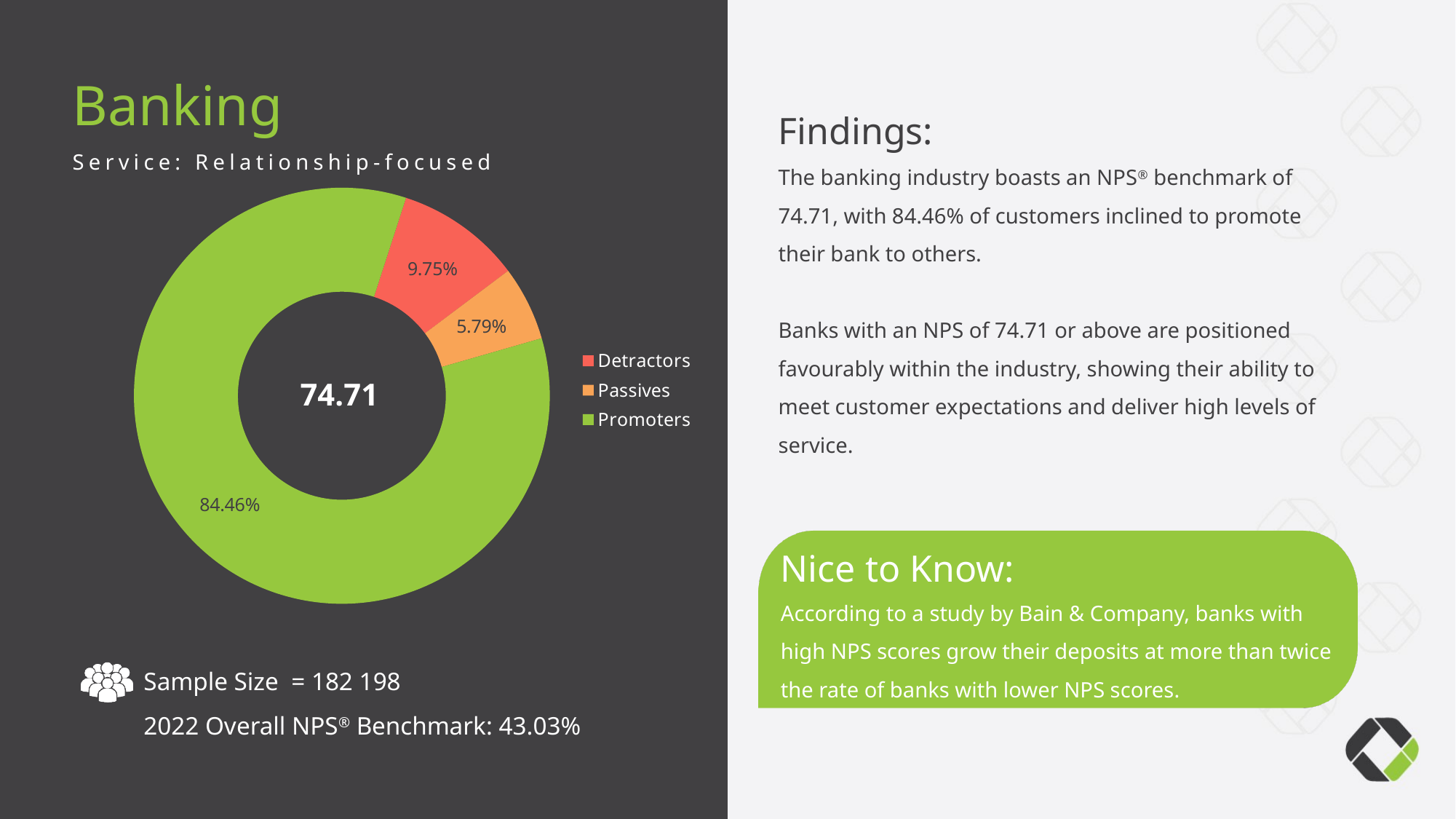
What percentage of the pie chart is Detractors? 9.75% What colour represents Promoters in the chart? Green What is the difference in percentage points between Promoters and Detractors? 74.71 How many categories does the pie chart show? 3 What number is displayed in the centre of the doughnut chart? 74.71 What percentage of the pie chart is Passives? 5.79% Which category has the largest share of the pie chart? Promoters Which category has the smallest share of the pie chart? Passives What kind of chart is shown on the slide? Pie chart (doughnut) What percentage of the pie chart is Promoters? 84.46% Which is larger, the Detractors slice or the Passives slice? Detractors What is the difference in percentage points between Detractors and Passives? 3.96